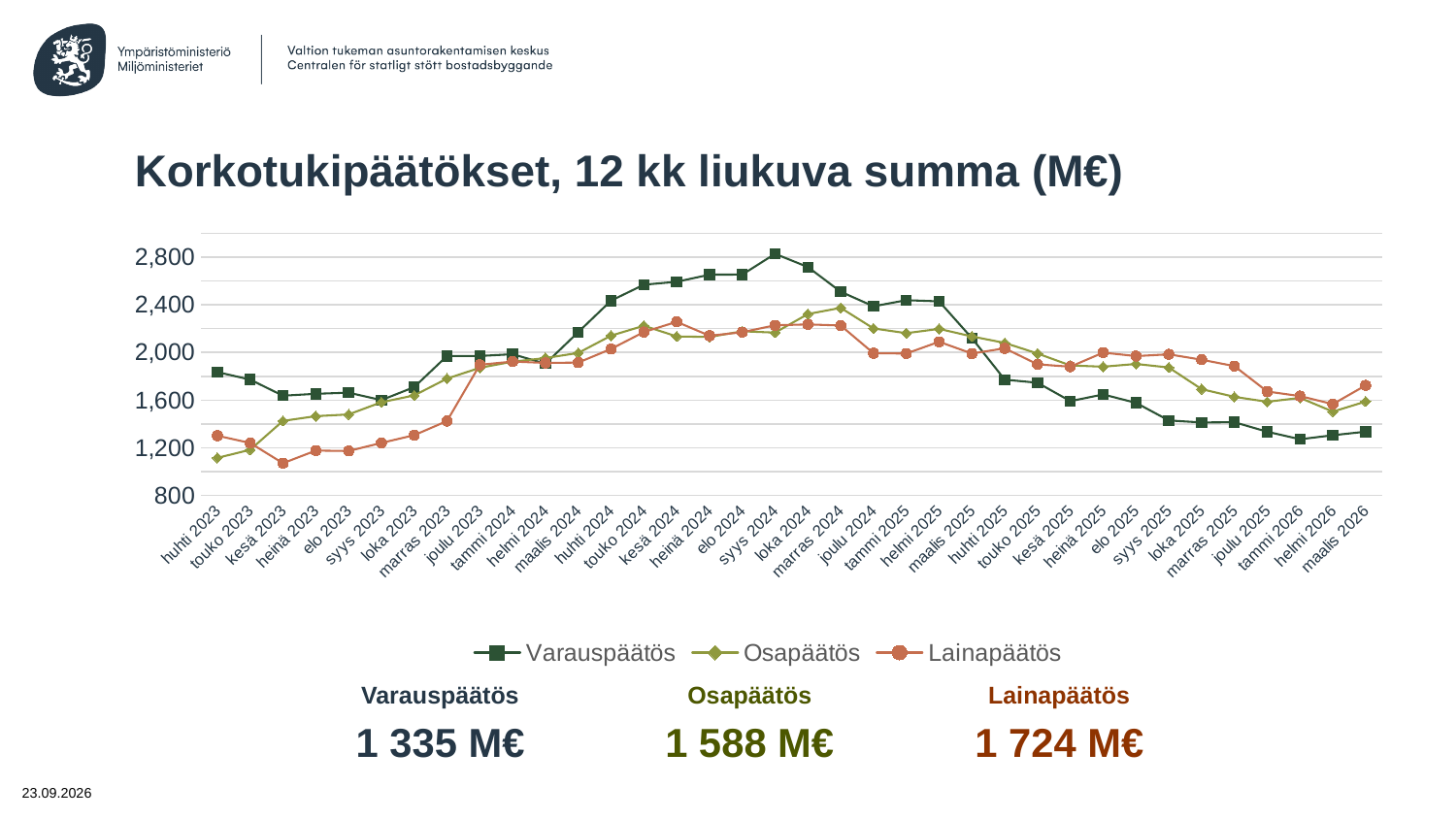
Is the value for Lainapäätös in kesä 2023 greater or less than 1,200? less How many series does the legend list? 3 What is the difference between the Lainapäätös and Varauspäätös values shown below the chart? 389 M€ In which month does the Varauspäätös line reach its highest point? syys 2024 Which series has the highest value shown below the chart? Lainapäätös What kind of chart is shown on the slide? line chart What is the title of the chart? Korkotukipäätökset, 12 kk liukuva summa (M€) What value is shown below the chart for Lainapäätös? 1 724 M€ Does the Varauspäätös line rise or fall from syys 2024 to maalis 2026? fall What value is shown below the chart for Varauspäätös? 1 335 M€ How many months are shown on the x axis? 36 Is the value for Varauspäätös in syys 2024 greater or less than 2,400? greater